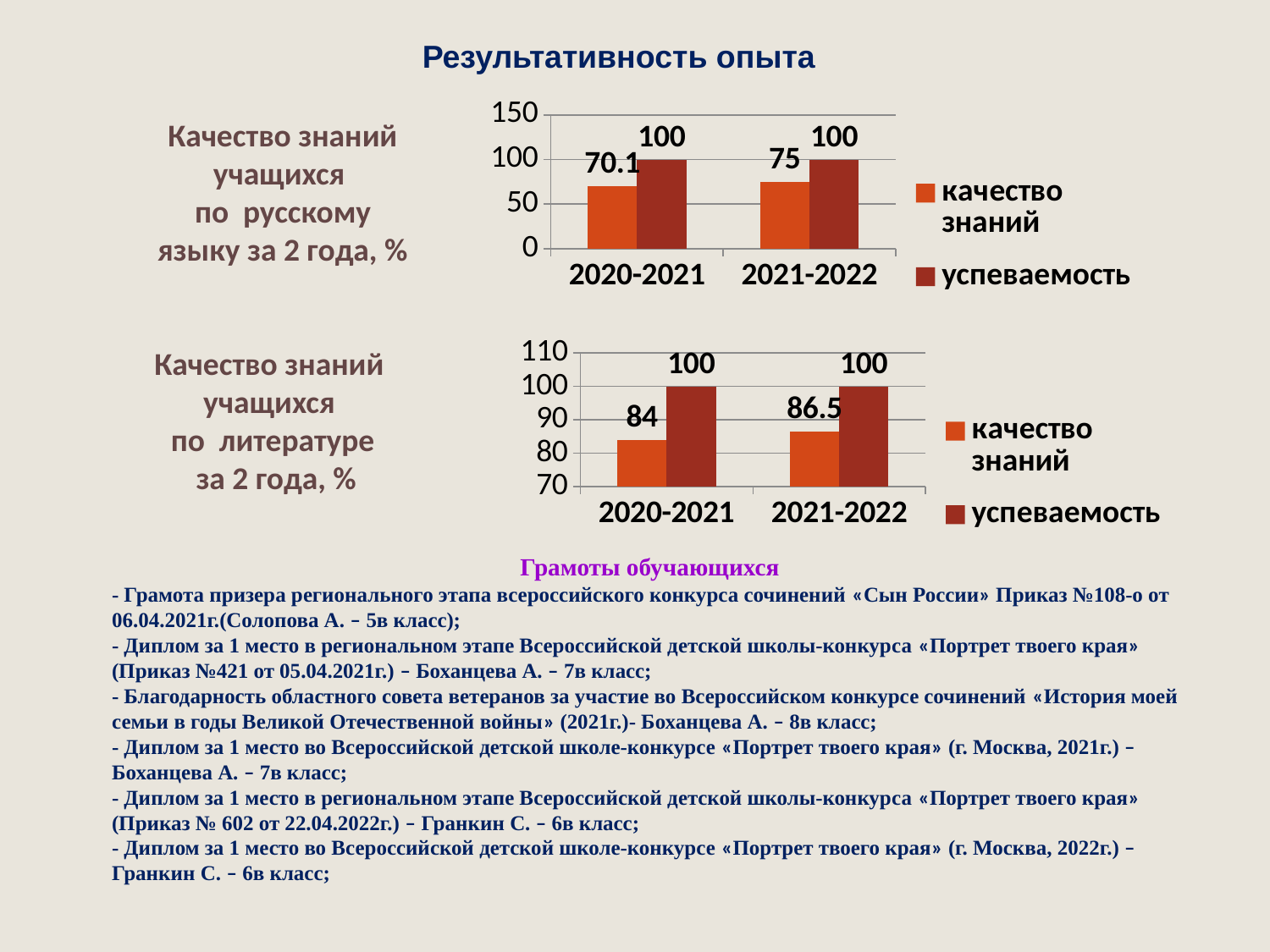
In the bottom chart (literature), what is the difference between 'качество знаний' in 2021-2022 and 2020-2021? 2.5 In the top chart (Russian language), what is the value of 'успеваемость' for 2021-2022? 100 In the top chart (Russian language), does 'качество знаний' rise or fall from 2020-2021 to 2021-2022? rise In the bottom chart (literature), which series is shown in dark red? успеваемость What kind of chart is the bottom chart (literature)? bar chart In the top chart (Russian language), what is the value of 'качество знаний' for 2020-2021? 70.1 In the bottom chart (literature), what is the value of 'качество знаний' for 2020-2021? 84 In the top chart (Russian language), what is the value of 'качество знаний' for 2021-2022? 75 In the top chart (Russian language), what is the difference between 'успеваемость' and 'качество знаний' for 2020-2021? 29.9 In the bottom chart (literature), what is the value of 'качество знаний' for 2021-2022? 86.5 How many categories are shown on the x axis of the top chart (Russian language)? 2 How many series does the legend of the bottom chart (literature) list? 2